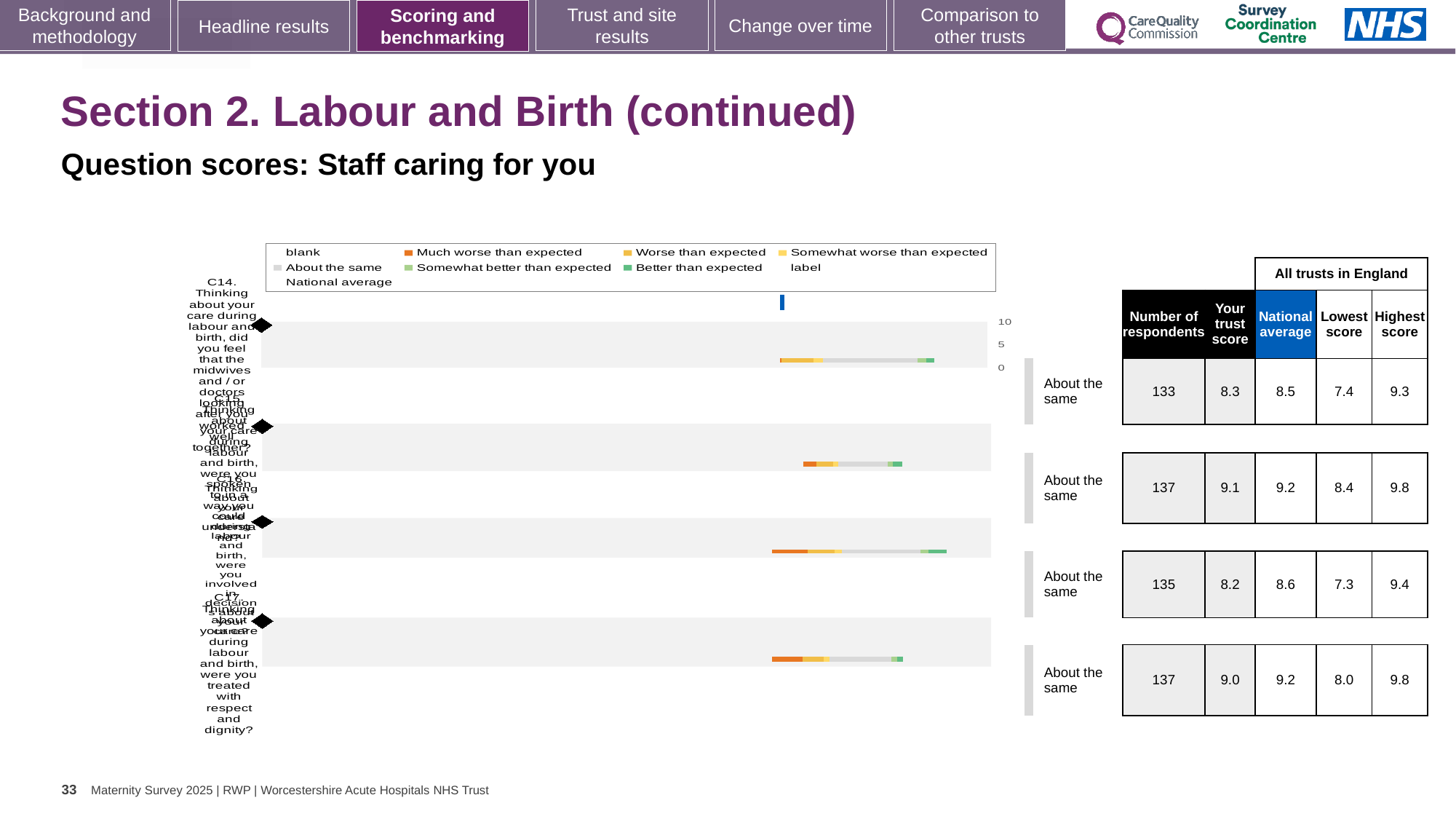
What kind of chart is shown on the slide? bar chart How many bars (question rows) does the chart contain? 4 How many entries does the chart legend list? 9 In the table beside the chart, what is the number of respondents for the first row? 133 In the table beside the chart, what is the lowest score for the fourth row? 8.0 In the table beside the chart, which is larger in the first row: the trust score or the national average? national average Which legend entry is shown in orange in the chart legend? Much worse than expected In the table beside the chart, what is the difference between the national average and the trust score in the third row? 0.4 What is the highest tick value shown on the chart's axis? 10 In the table beside the chart, which row has the lowest 'Lowest score' value? third row (7.3) In the table beside the chart, what is the trust score for the second row? 9.1 In the table beside the chart, what is the national average for the third row? 8.6